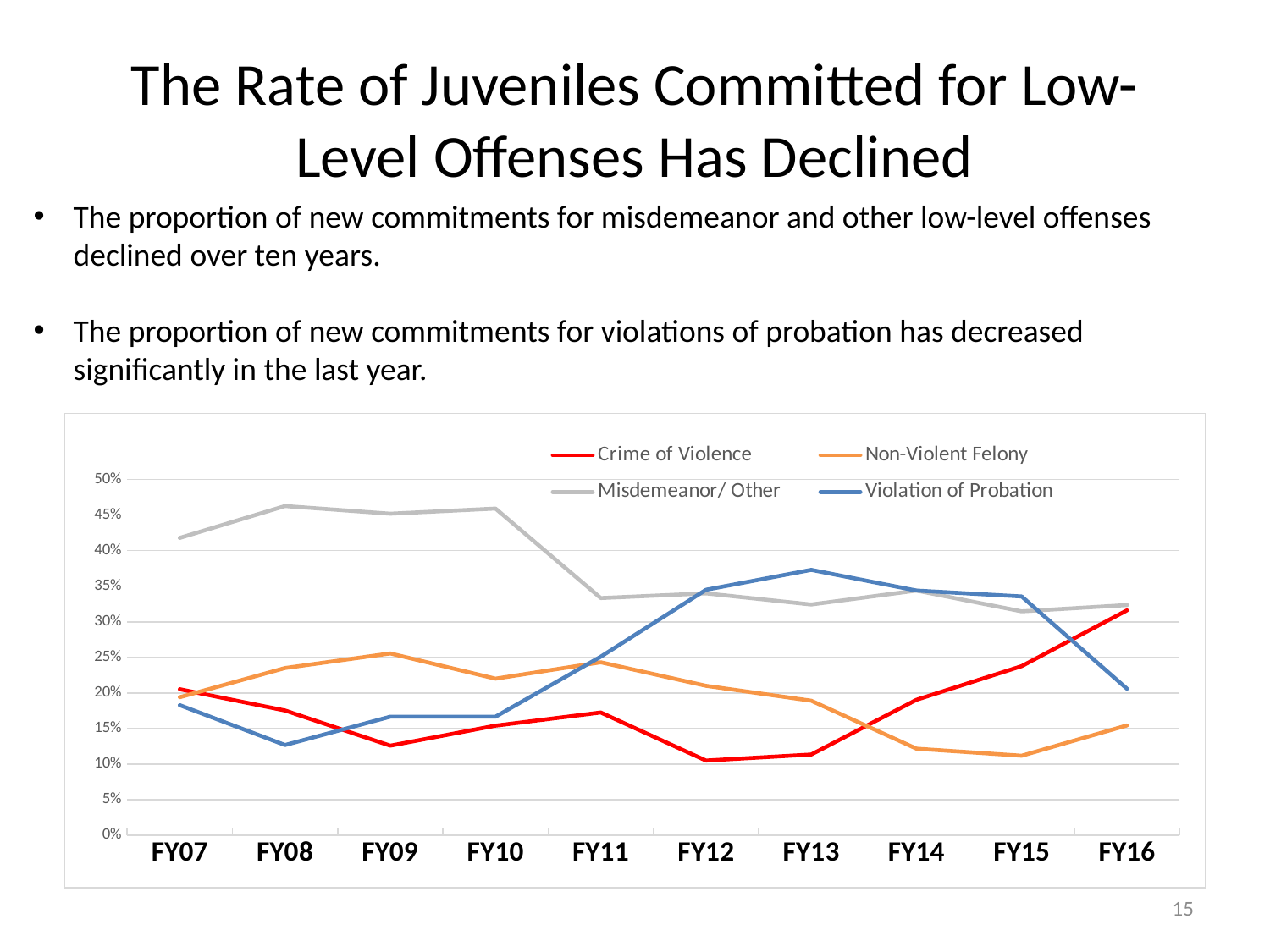
What colour is the Crime of Violence line in the chart? red How many fiscal years are plotted along the x axis of the chart? 10 What kind of chart is shown on the slide? line chart Is the value for Violation of Probation in FY16 greater or less than 25%? less In which fiscal year does the Violation of Probation series reach its highest value? FY13 Does the Crime of Violence series rise or fall from FY13 to FY16? rise Is the value for Crime of Violence in FY12 greater or less than 15%? less Does the Misdemeanor/ Other series rise or fall from FY10 to FY11? fall In FY16, which is larger: Crime of Violence or Non-Violent Felony? Crime of Violence Which series has the highest value in FY07? Misdemeanor/ Other Is the value for Misdemeanor/ Other in FY08 greater or less than 40%? greater How many series does the chart's legend list? 4